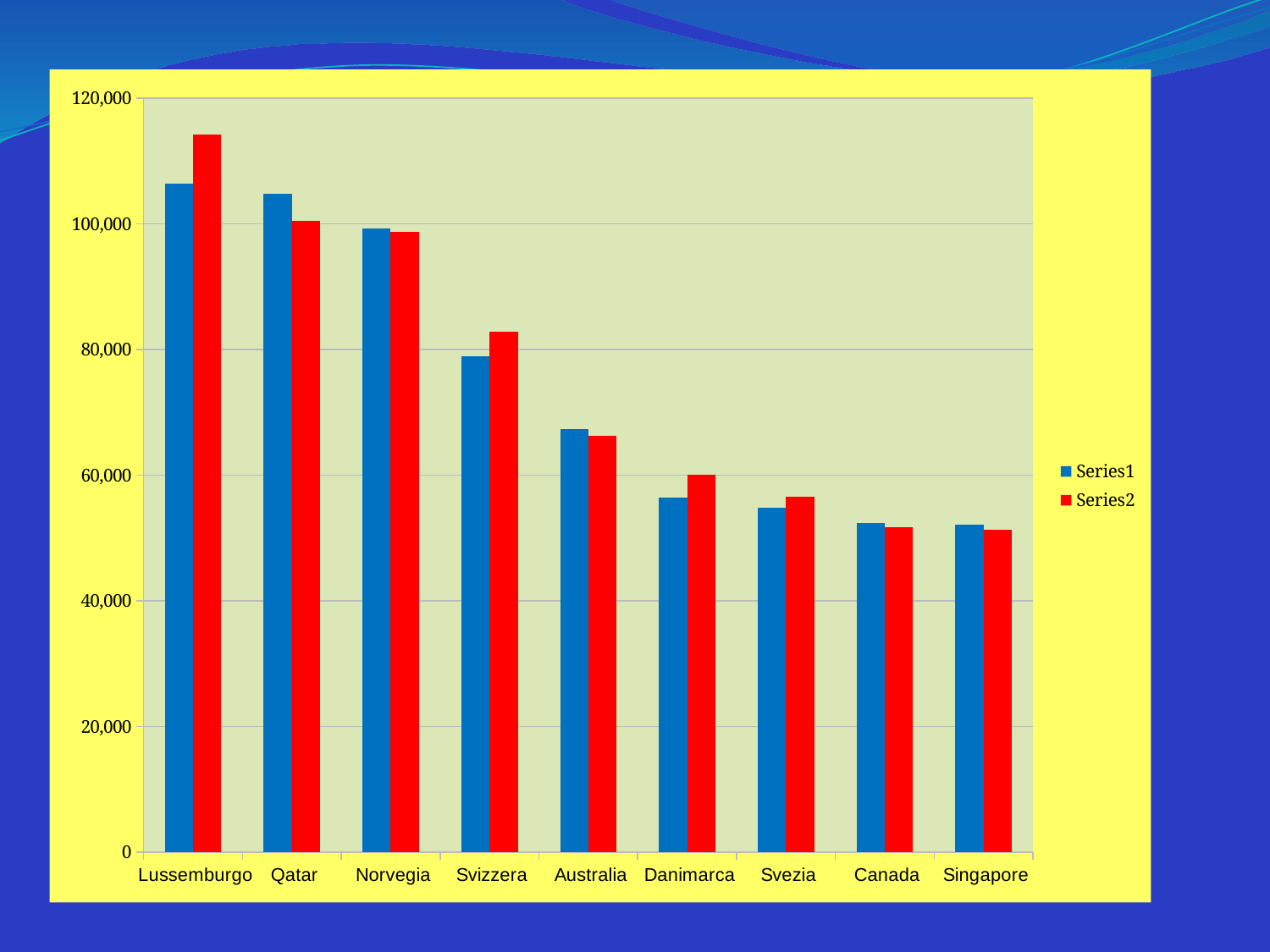
What kind of chart is shown on the slide? bar chart How many countries are shown on the x axis of the chart? 9 Is the Series1 value for Svezia greater or less than 60,000? less Which country has the highest Series2 value? Lussemburgo Is the Series1 value for Svizzera greater or less than 80,000? less What colour are the Series2 bars? red For Lussemburgo, which is larger, Series1 or Series2? Series2 Is the Series1 value for Australia greater or less than 60,000? greater For Qatar, which is larger, Series1 or Series2? Series1 Do the Series1 values rise or fall from Lussemburgo to Singapore along the x axis? fall How many series does the legend list? 2